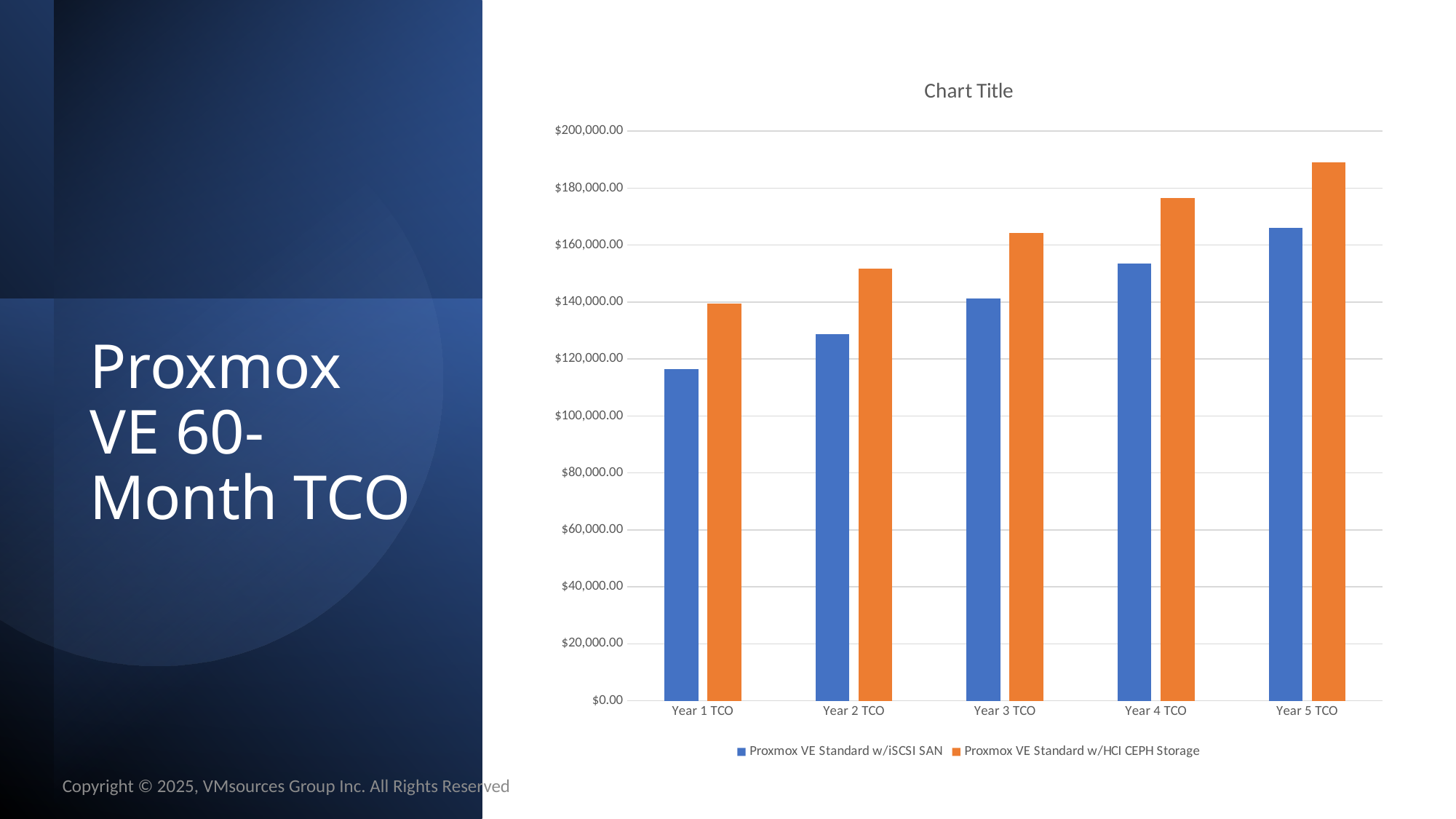
What kind of chart is shown on the slide? bar chart Which category has the highest value for Proxmox VE Standard w/HCI CEPH Storage? Year 5 TCO How many categories are shown on the x axis? 5 How many series does the legend list? 2 Is the Year 5 TCO value for Proxmox VE Standard w/HCI CEPH Storage greater or less than $180,000.00? greater Do the values for Proxmox VE Standard w/iSCSI SAN rise or fall from Year 1 TCO to Year 5 TCO? rise What colour are the bars for Proxmox VE Standard w/HCI CEPH Storage? orange For Year 2 TCO, which series has the larger value: Proxmox VE Standard w/iSCSI SAN or Proxmox VE Standard w/HCI CEPH Storage? Proxmox VE Standard w/HCI CEPH Storage Which category has the lowest value for Proxmox VE Standard w/iSCSI SAN? Year 1 TCO Is the Year 4 TCO value for Proxmox VE Standard w/iSCSI SAN greater or less than $160,000.00? less Is the Year 1 TCO value for Proxmox VE Standard w/iSCSI SAN greater or less than $120,000.00? less